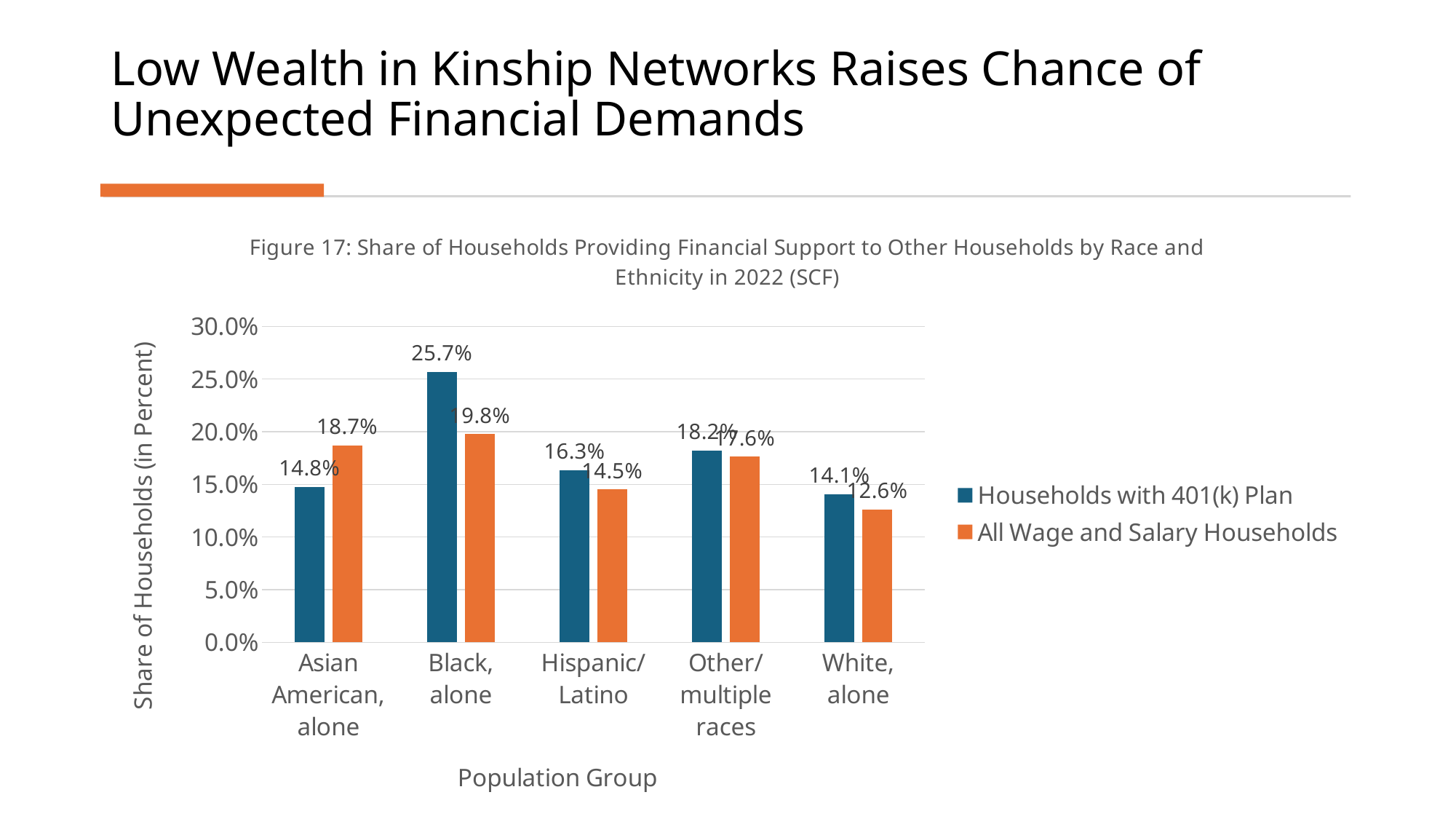
How many series does the legend list? 2 Is the value for Hispanic/Latino among Households with 401(k) Plan greater or less than 15.0%? greater Which population group has the lowest value for All Wage and Salary Households? White, alone What is the value for White, alone among All Wage and Salary Households? 12.6% How many population groups are shown on the x axis? 5 What is the value for Asian American, alone among All Wage and Salary Households? 18.7% For Asian American, alone, which series has the larger value: Households with 401(k) Plan or All Wage and Salary Households? All Wage and Salary Households What is the difference between the Households with 401(k) Plan and All Wage and Salary Households values for Black, alone? 5.9% What is the label of the y axis? Share of Households (in Percent) What is the value for Black, alone among Households with 401(k) Plan? 25.7% Which population group has the highest value for Households with 401(k) Plan? Black, alone What kind of chart is shown on the slide? Bar chart